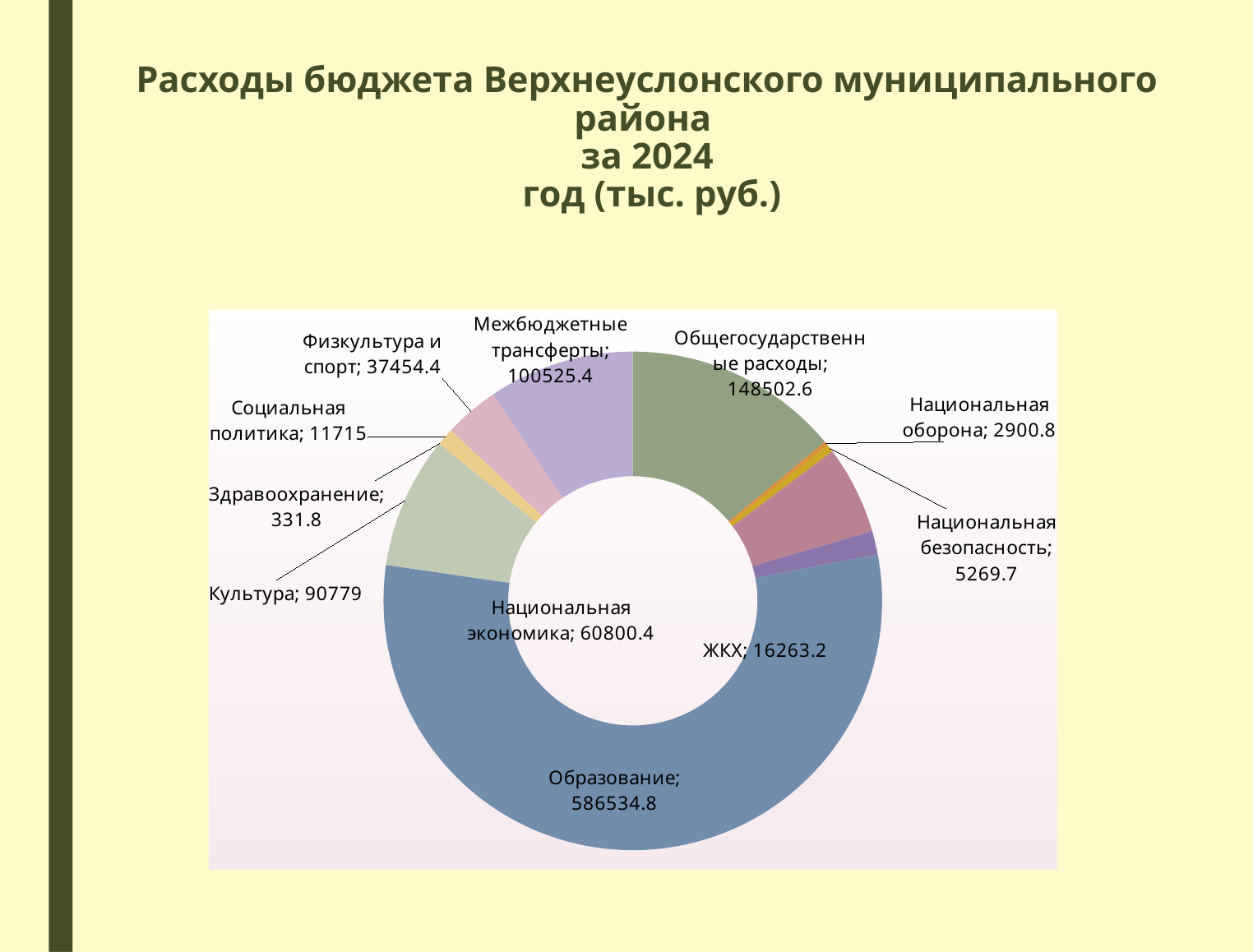
How many categories are shown in the chart? 11 What is the value for ЖКХ? 16263.2 What is the value for Образование? 586534.8 Which category has the highest value? Образование What is the value for Здравоохранение? 331.8 What kind of chart is shown on the slide? doughnut chart What is the value for Межбюджетные трансферты? 100525.4 What is the value for Национальная оборона? 2900.8 Which category has the lowest value? Здравоохранение What is the difference between Образование and Общегосударственные расходы? 438032.2 Which is larger, Национальная экономика or Физкультура и спорт? Национальная экономика What is the difference between Межбюджетные трансферты and Культура? 9746.4